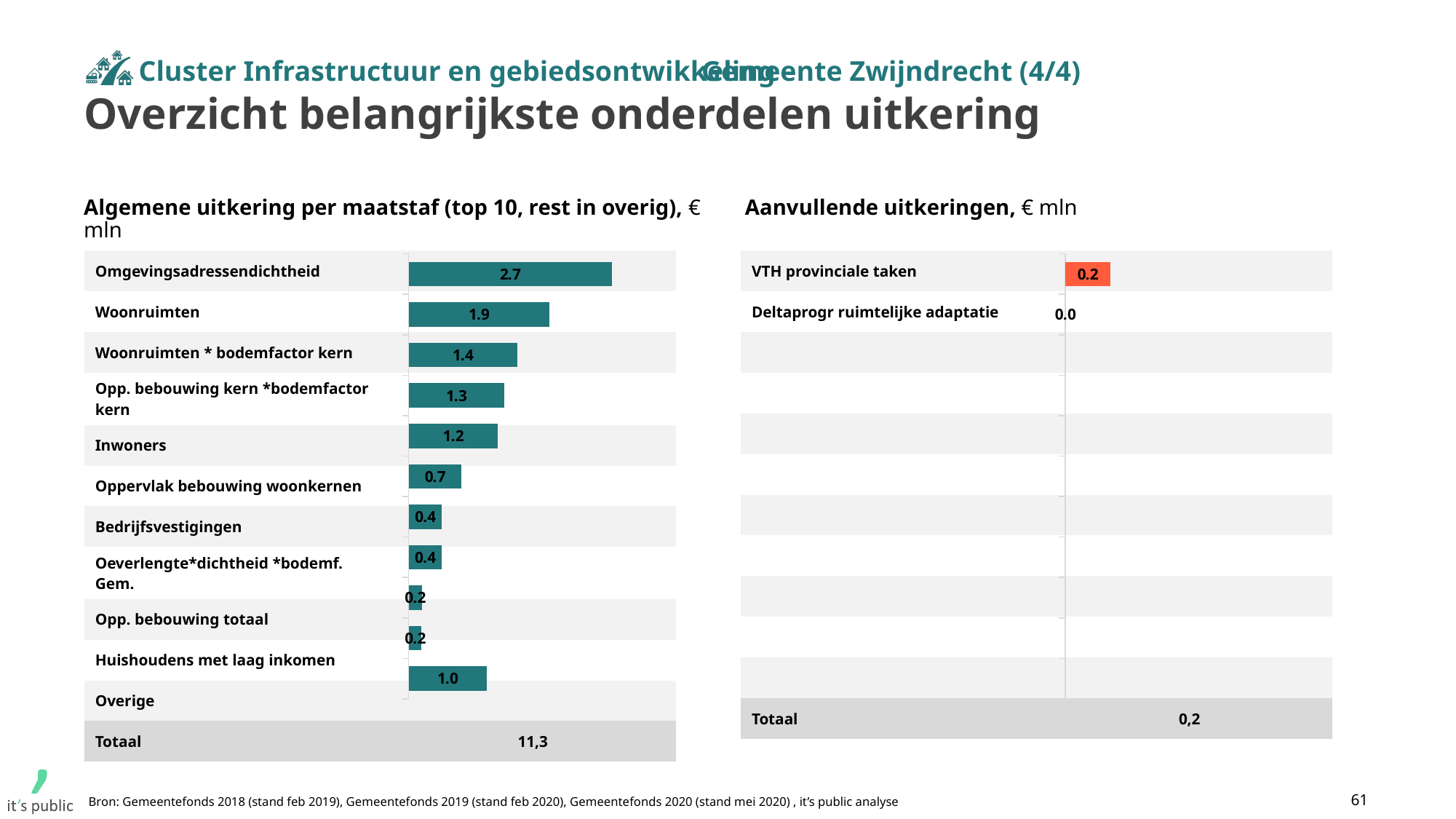
In the 'Algemene uitkering per maatstaf' chart, which category has the highest value? Omgevingsadressendichtheid In the 'Aanvullende uitkeringen' chart, what is the value for VTH provinciale taken? 0.2 In the 'Algemene uitkering per maatstaf' chart, how many categories (bars) are shown? 11 In the 'Aanvullende uitkeringen' chart, what colour is the bar for VTH provinciale taken? Orange In the 'Aanvullende uitkeringen' chart, what is the value for Deltaprogr ruimtelijke adaptatie? 0.0 In the 'Algemene uitkering per maatstaf' chart, what is the value for Omgevingsadressendichtheid? 2.7 In the 'Algemene uitkering per maatstaf' chart, what is the Totaal shown at the bottom? 11,3 In the 'Algemene uitkering per maatstaf' chart, which is larger: Woonruimten * bodemfactor kern or Oppervlak bebouwing woonkernen? Woonruimten * bodemfactor kern In the 'Algemene uitkering per maatstaf' chart, what is the difference between Omgevingsadressendichtheid and Woonruimten? 0.8 In the 'Algemene uitkering per maatstaf' chart, what is the value for Overige? 1.0 What kind of chart is the 'Algemene uitkering per maatstaf' chart? Bar chart In the 'Algemene uitkering per maatstaf' chart, what is the value for Inwoners? 1.2